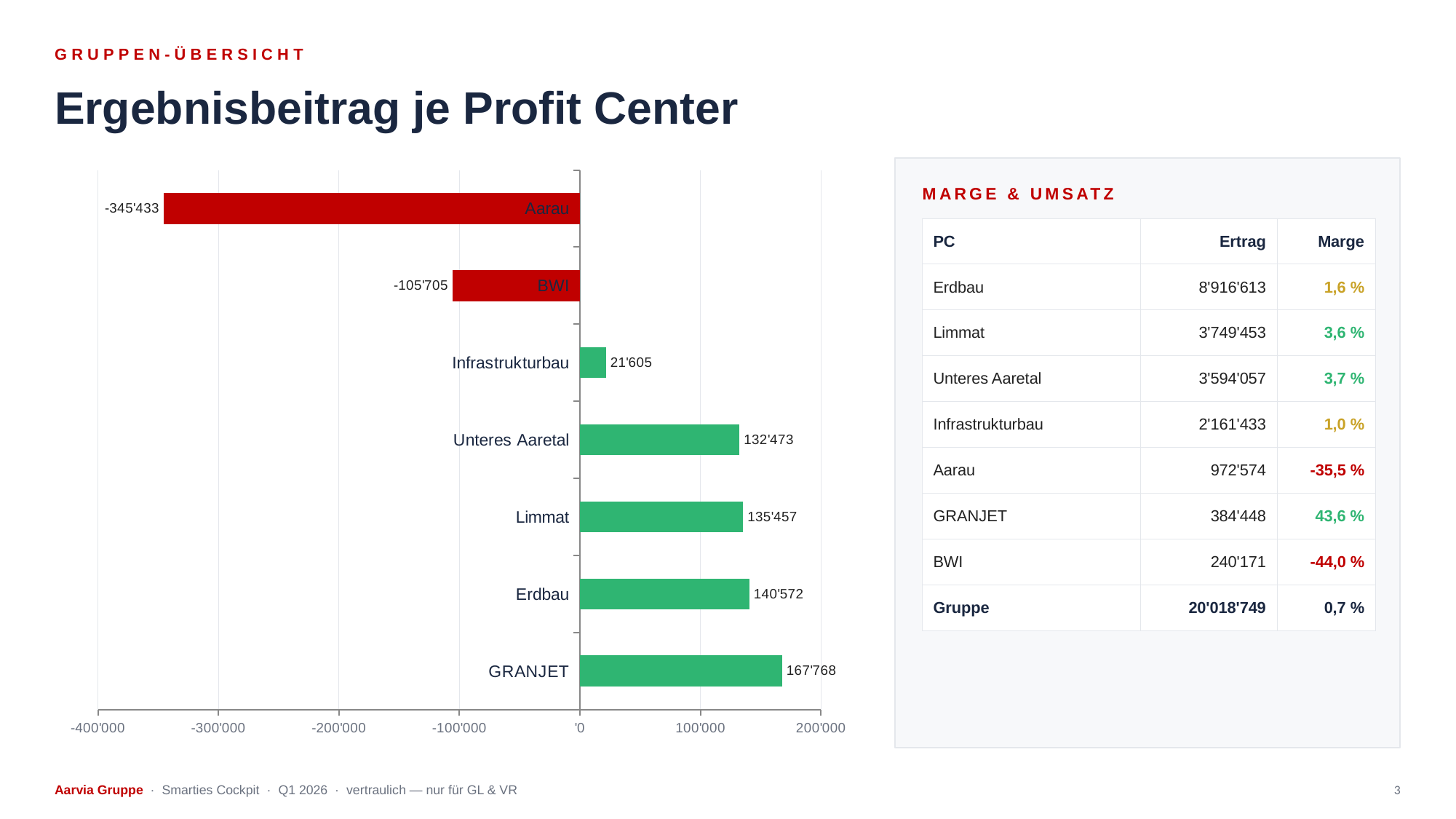
Which profit center has the highest value in the chart? GRANJET What is the difference between the values for GRANJET and Erdbau? 27'196 Which is larger, the value for Erdbau or the value for Limmat? Erdbau What is the value for GRANJET in the chart? 167'768 What is the value for Infrastrukturbau in the chart? 21'605 Is the value for Aarau greater or less than -300'000? less What kind of chart is shown on the slide? bar chart What is the value for Aarau in the chart? -345'433 What is the difference between the values for Limmat and Unteres Aaretal? 2'984 What is the value for BWI in the chart? -105'705 How many profit centers are shown in the chart? 7 Which profit center has the lowest value in the chart? Aarau